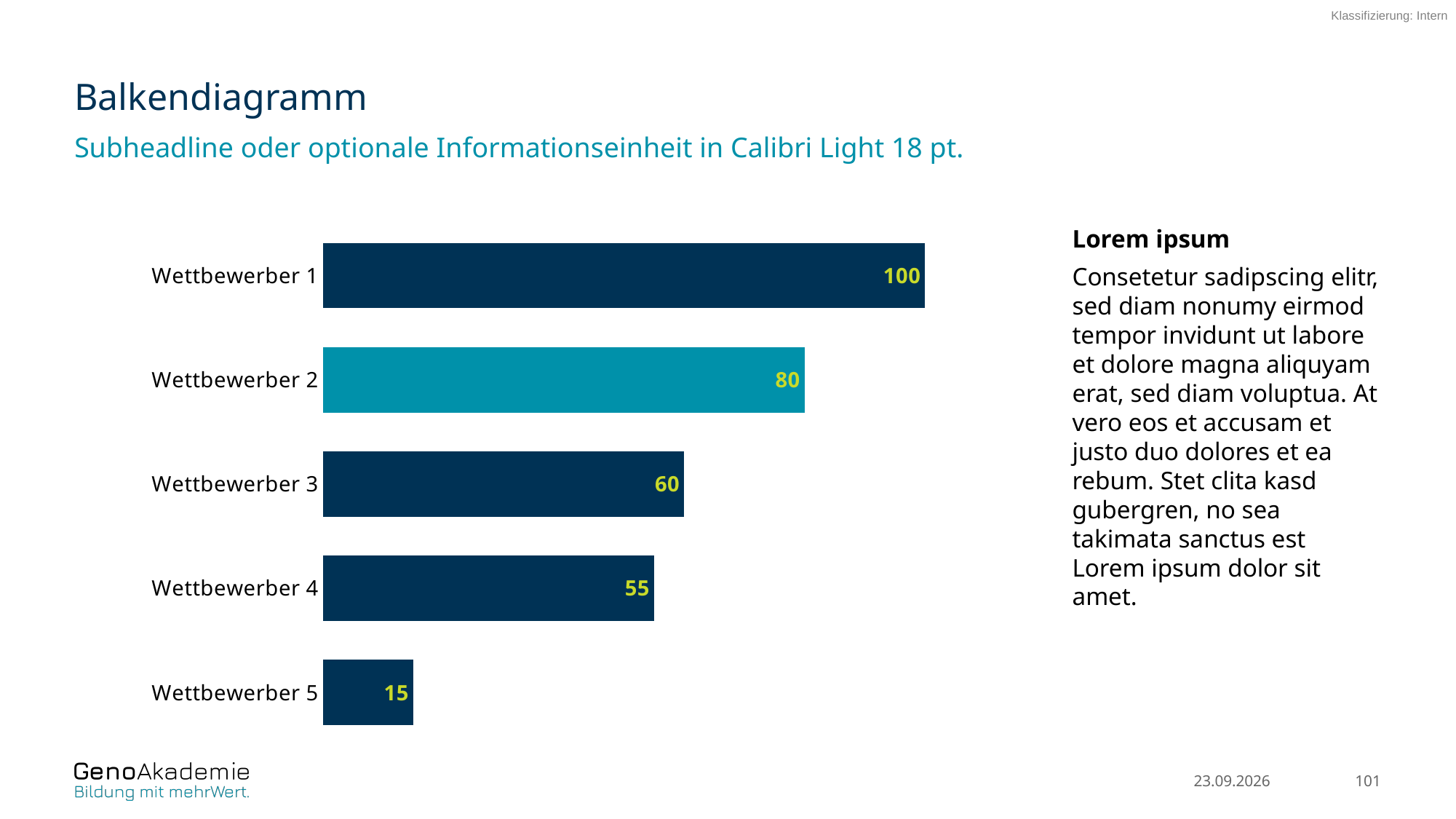
What is the value for Wettbewerber 2? 80 How many categories are shown in the chart? 5 Which category has the lowest value? Wettbewerber 5 What is the value for Wettbewerber 4? 55 Which category has the highest value? Wettbewerber 1 Which has a larger value, Wettbewerber 3 or Wettbewerber 4? Wettbewerber 3 What is the value for Wettbewerber 5? 15 Which bar is shown in a different (lighter teal) colour from the others? Wettbewerber 2 What is the value for Wettbewerber 1? 100 What is the difference between the values for Wettbewerber 1 and Wettbewerber 2? 20 What is the difference between the values for Wettbewerber 3 and Wettbewerber 5? 45 What kind of chart is shown on the slide? bar chart